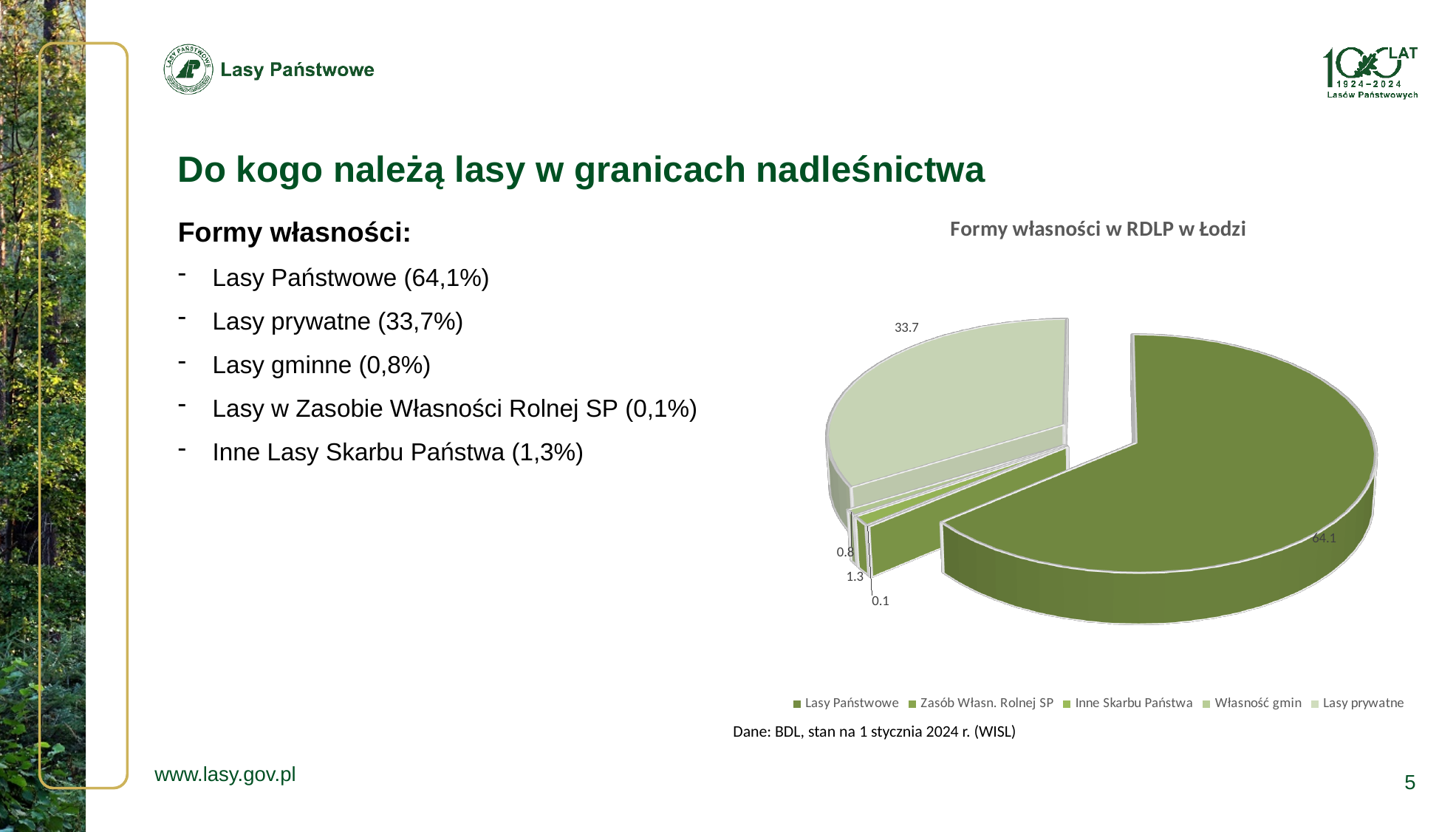
What is the difference between the values for Lasy Państwowe and Lasy prywatne? 30.4 What is the title of the chart? Formy własności w RDLP w Łodzi What value is shown for Własność gmin in the pie chart? 0.8 What kind of chart is shown on the slide? Pie chart Which category has the largest slice in the pie chart? Lasy Państwowe What value is shown for Lasy Państwowe in the pie chart? 64.1 What value is shown for Zasób Własn. Rolnej SP in the pie chart? 0.1 How many categories does the legend of the pie chart list? 5 What value is shown for Inne Skarbu Państwa in the pie chart? 1.3 Which category has the smallest slice in the pie chart? Zasób Własn. Rolnej SP Which is larger in the pie chart: Inne Skarbu Państwa or Własność gmin? Inne Skarbu Państwa What value is shown for Lasy prywatne in the pie chart? 33.7